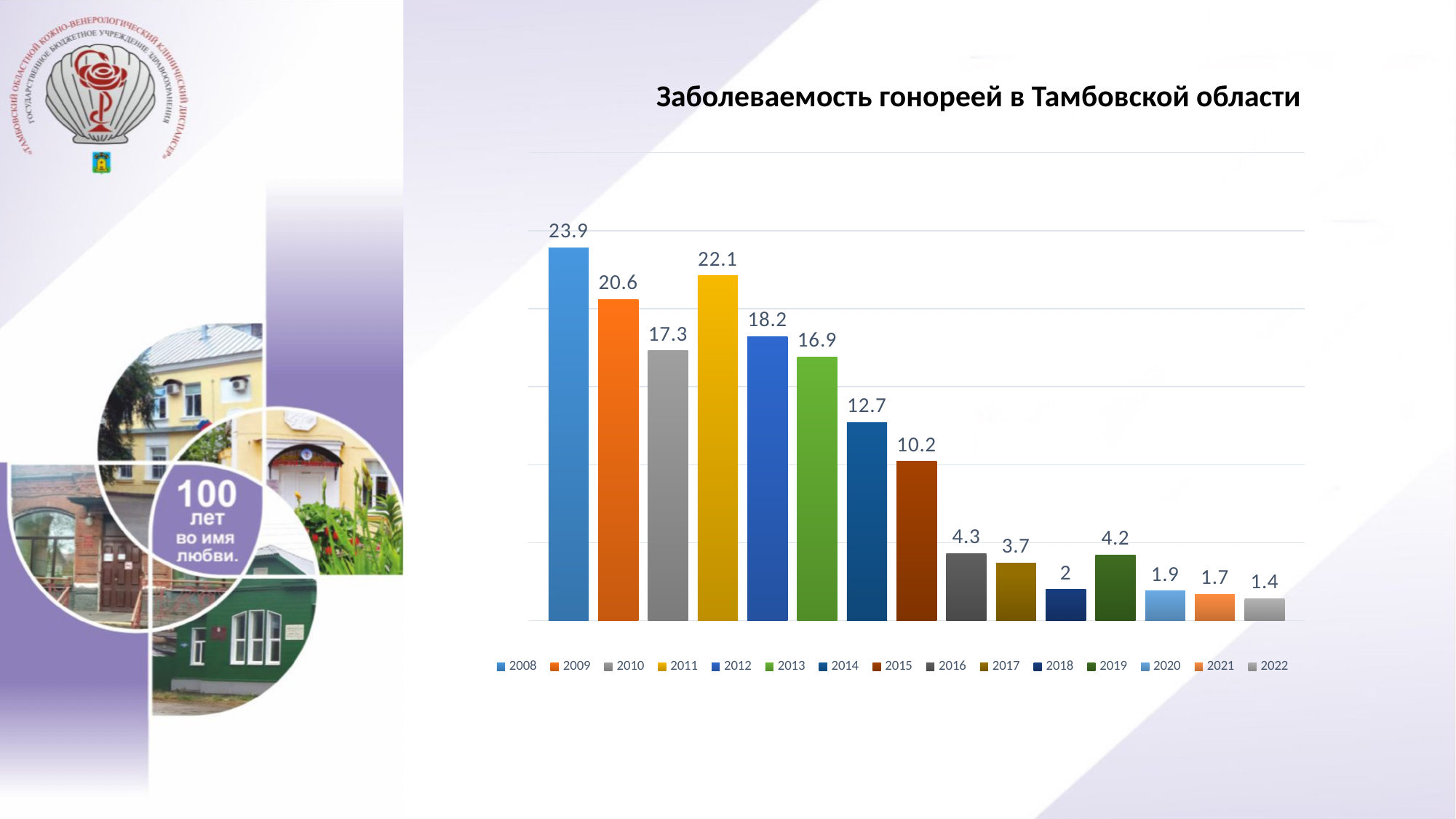
What is the value for 2022? 1.4 Which year has the highest value? 2008 What kind of chart is this? Bar chart What is the value for 2015? 10.2 Which year has the lowest value? 2022 Which is larger, the value for 2016 or the value for 2019? 2016 What is the difference between the values for 2008 and 2009? 3.3 How many years are shown in the chart? 15 What is the value for 2008? 23.9 Which is larger, the value for 2011 or the value for 2012? 2011 What is the title of the chart? Заболеваемость гонореей в Тамбовской области What is the difference between the values for 2015 and 2016? 5.9